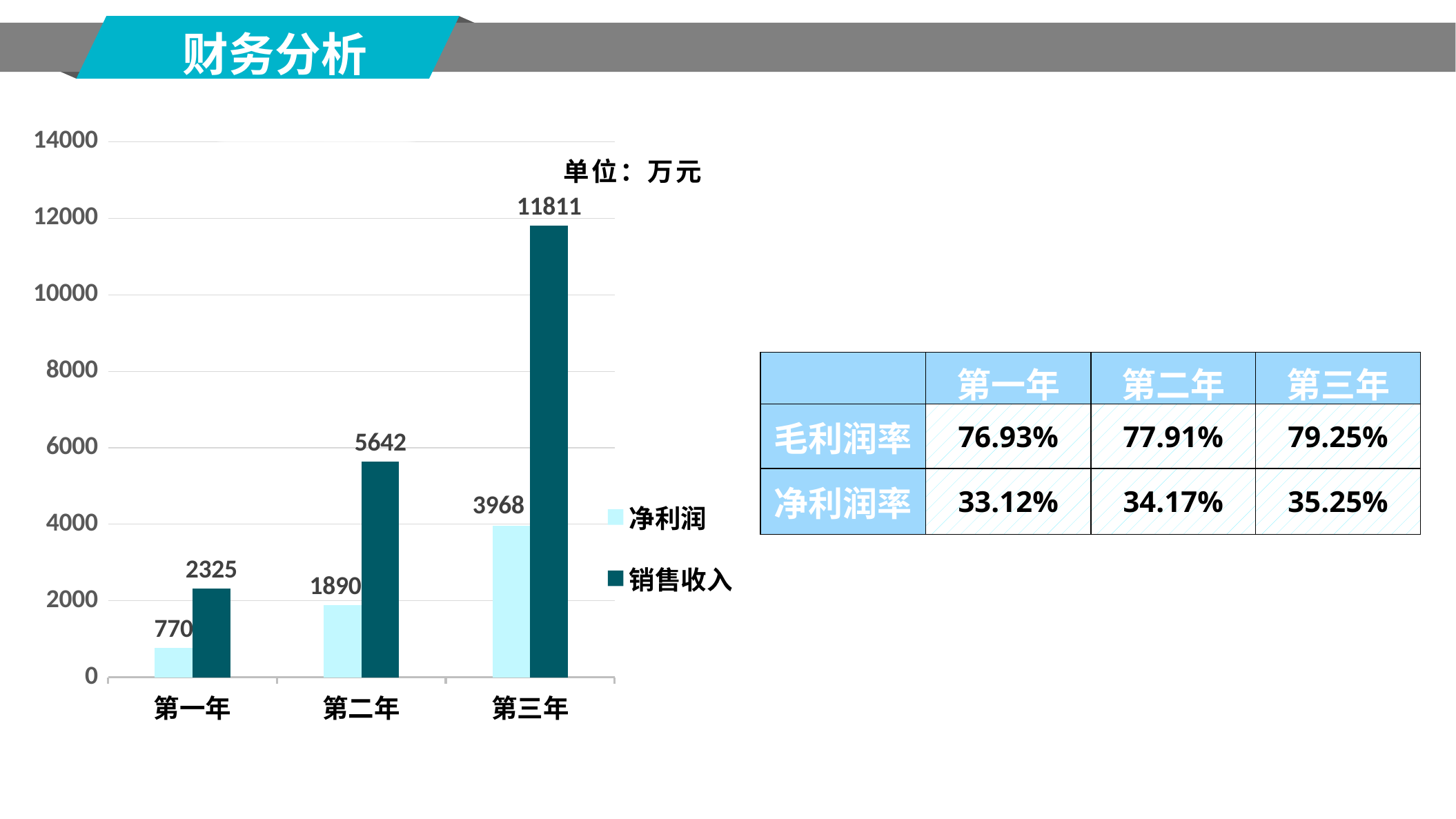
Which year has the lowest 净利润? 第一年 What is the 净利润 value for 第二年? 1890 What is the 销售收入 value for 第三年? 11811 How many years are shown on the x axis of the chart? 3 How many series does the chart legend list? 2 What kind of chart is shown on the slide? bar chart Which is larger: 净利润 in 第三年 or 销售收入 in 第一年? 净利润 in 第三年 Does 销售收入 rise or fall from 第一年 to 第三年? rise What is the difference between 销售收入 and 净利润 in 第二年? 3752 What is the difference in 销售收入 between 第三年 and 第二年? 6169 Which year has the highest 销售收入? 第三年 What is the 净利润 value for 第一年? 770